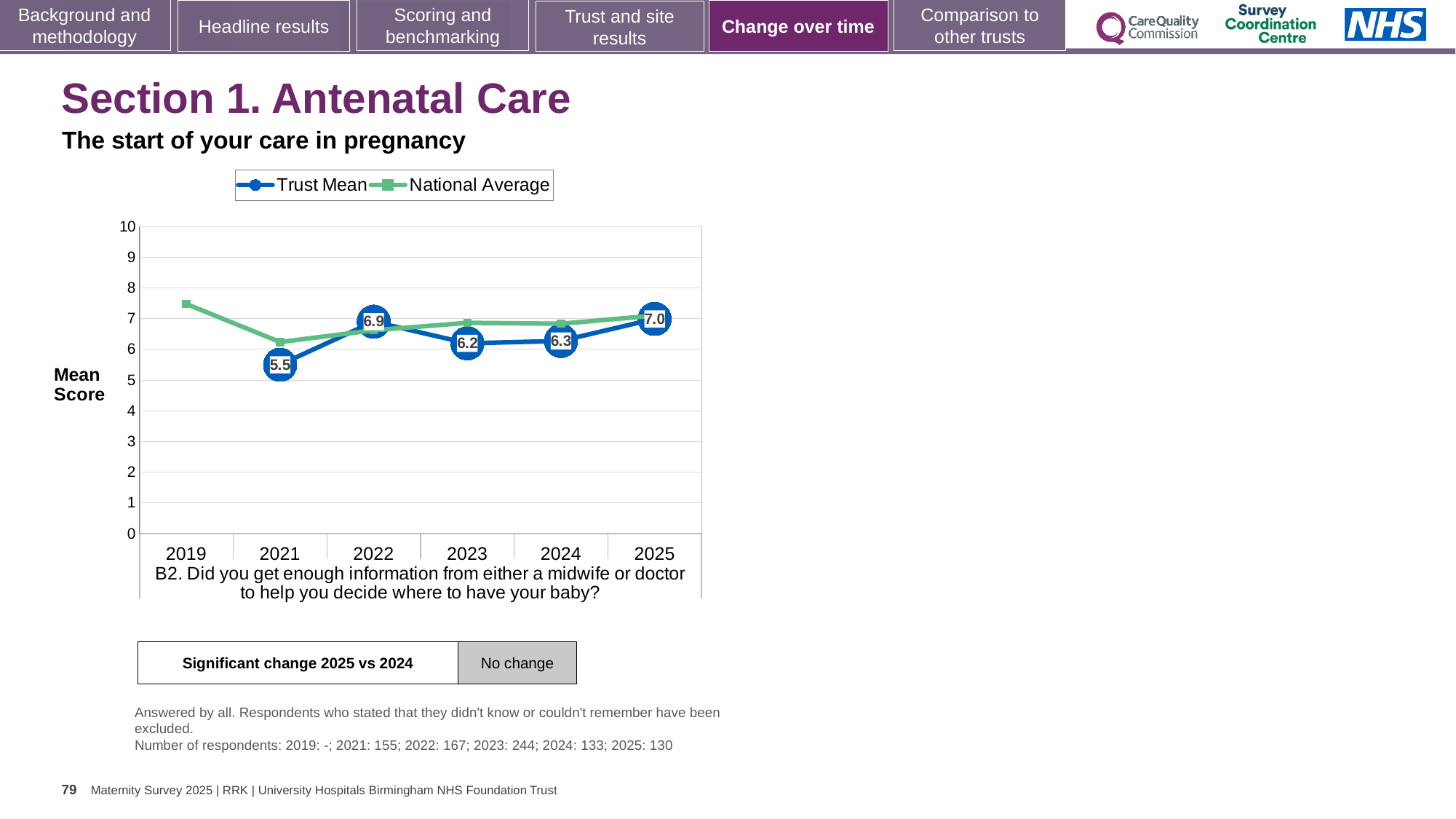
Which year has the larger Trust Mean score, 2022 or 2023? 2022 Is the National Average value for 2019 greater or less than 7? greater Is the National Average value for 2021 greater or less than 7? less How many series does the chart legend list? 2 What is the Trust Mean score for 2021? 5.5 In which year is the Trust Mean score lowest? 2021 What is the Trust Mean score for 2025? 7.0 What is the difference between the Trust Mean scores for 2025 and 2024? 0.7 In which year is the Trust Mean score highest? 2025 What kind of chart is shown on the slide? Line chart What is the difference between the Trust Mean scores for 2022 and 2021? 1.4 How many years are shown on the x axis of the chart? 6